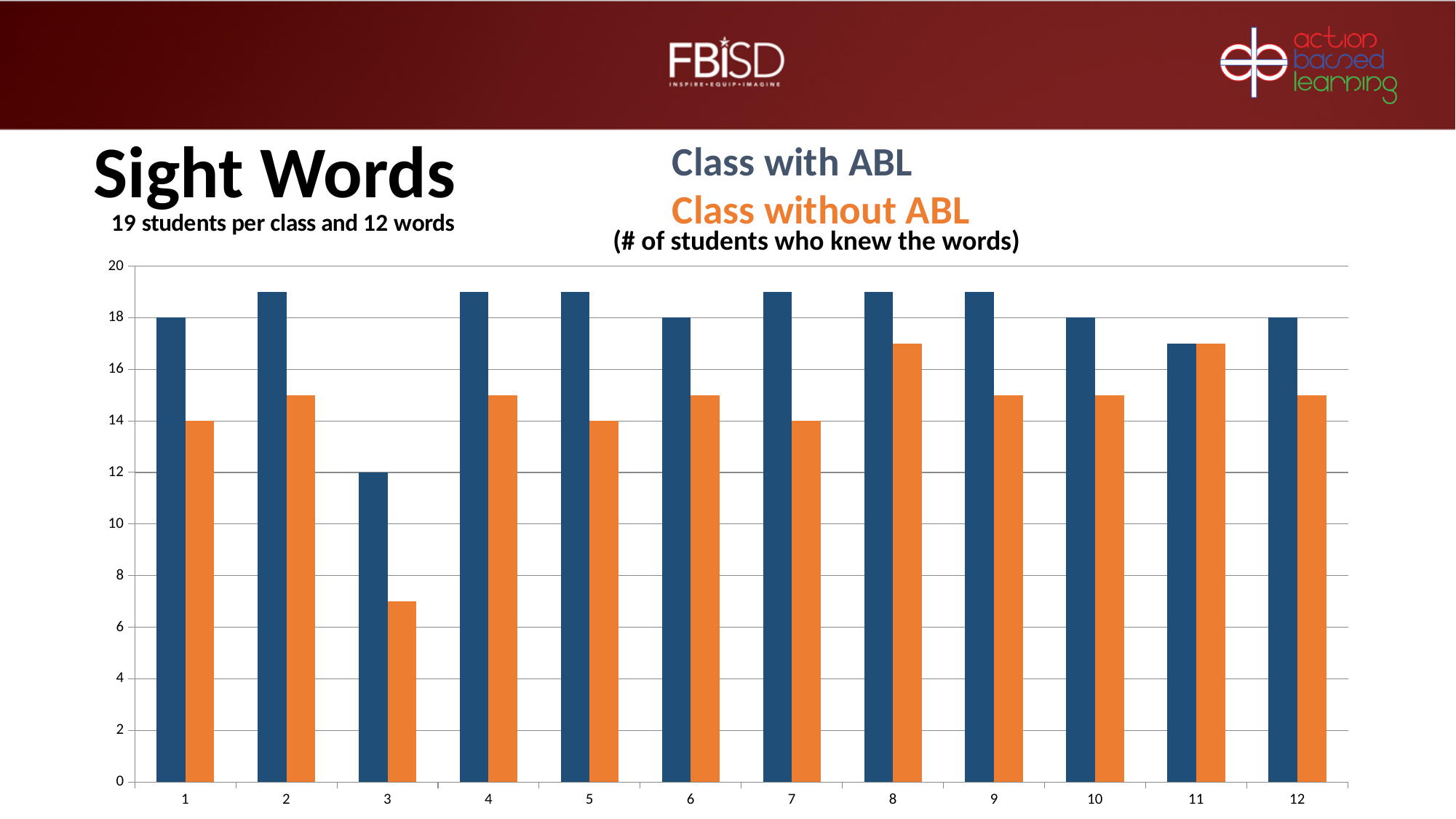
How many words (categories) are shown on the x axis? 12 How many students in the class without ABL knew word 1? 14 For which word did the fewest students in the class without ABL know the word? 3 How many students in the class with ABL knew word 1? 18 For word 3, which class had more students who knew the word, the class with ABL or the class without ABL? Class with ABL What type of chart is shown on the slide? bar chart How many students in the class with ABL knew word 3? 12 Is the value for the class without ABL on word 3 greater or less than 8? less How many series does the chart show? 2 For word 1, what is the difference between the class with ABL and the class without ABL? 4 Which colour represents the class without ABL? orange How many students in the class without ABL knew word 5? 14